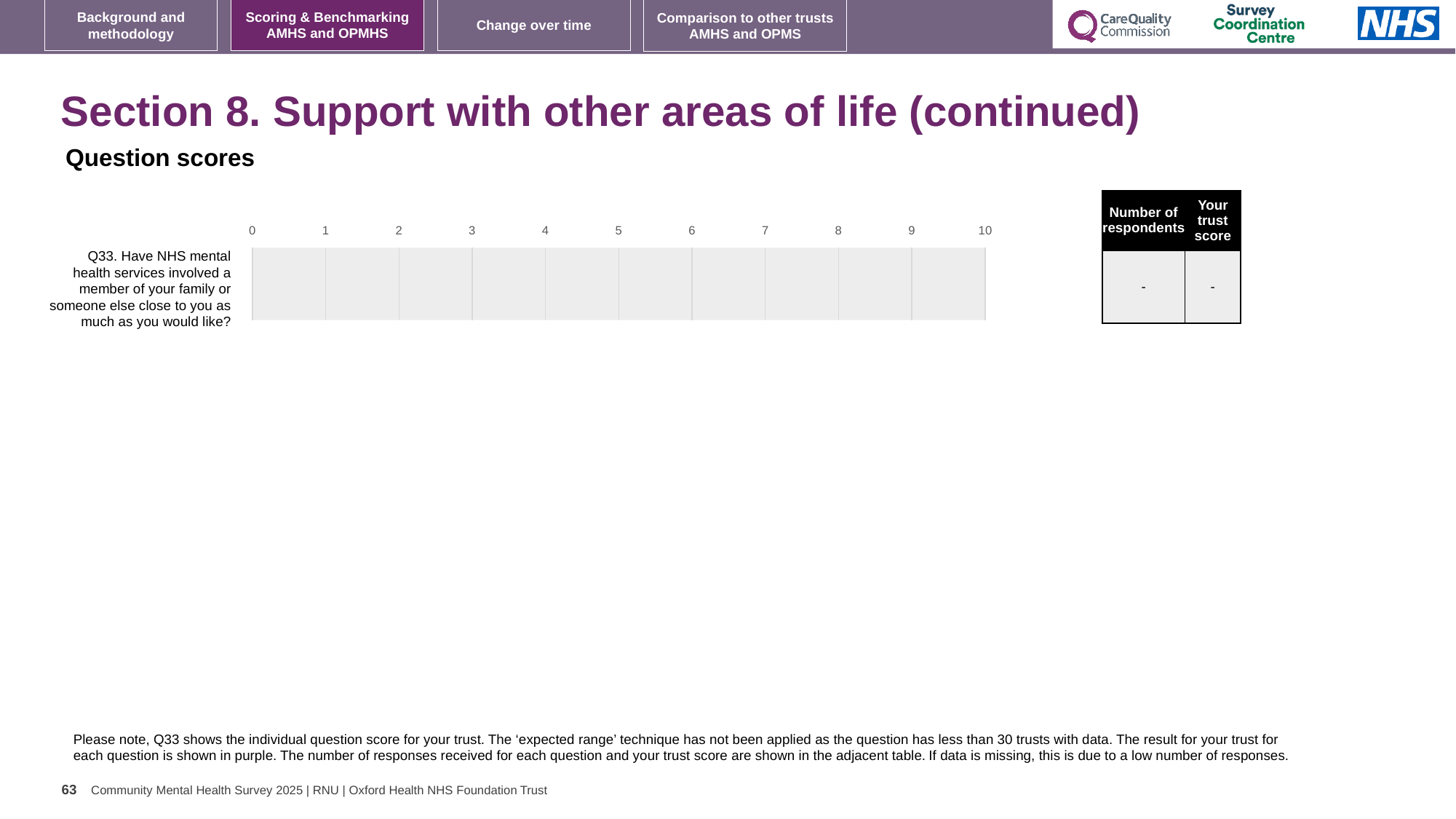
Is a bar plotted for Q33 on the chart? No What is the highest value shown on the chart's x axis? 10 What is the lowest value shown on the chart's x axis? 0 How many questions (categories) are listed on the chart? 1 What value is shown in the 'Your trust score' column of the table for Q33? - What kind of chart is shown on the slide? bar chart What value is shown in the 'Number of respondents' column of the table for Q33? -